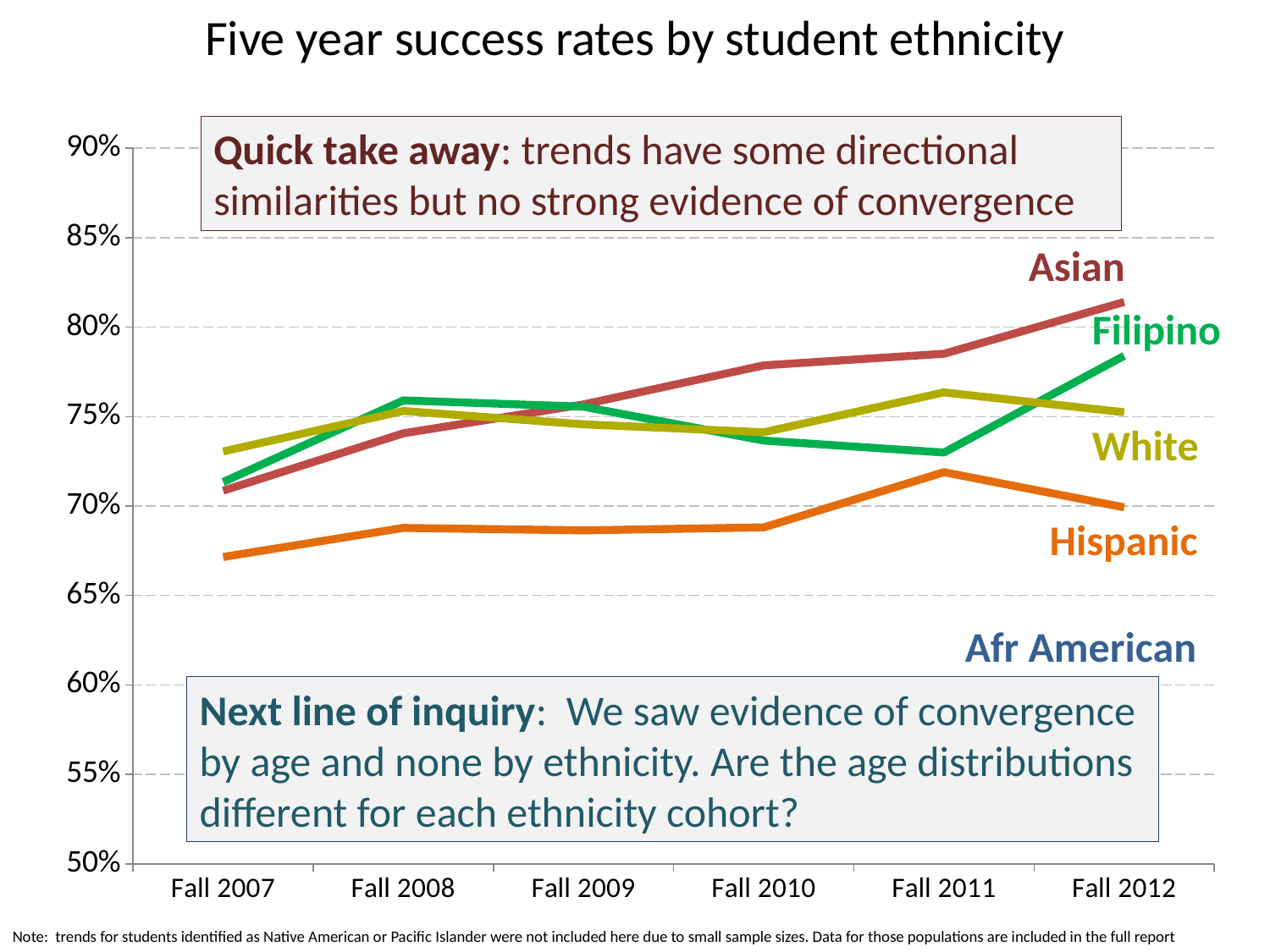
How many Fall terms are shown along the x axis? 6 Does the Asian line rise or fall from Fall 2007 to Fall 2012? rise Is the value for Asian in Fall 2012 greater or less than 80%? greater Is the value for White in Fall 2007 greater or less than 70%? greater What kind of chart is shown on the slide? line chart Which two groups does the note say were not included due to small sample sizes? Native American or Pacific Islander What is the title of the chart? Five year success rates by student ethnicity Is the value for Filipino in Fall 2012 greater or less than 80%? less In Fall 2010, which is larger, the value for Asian or the value for Filipino? Asian How many ethnicity groups are labelled on the chart? 5 Which of the labelled lines has the highest value in Fall 2012? Asian